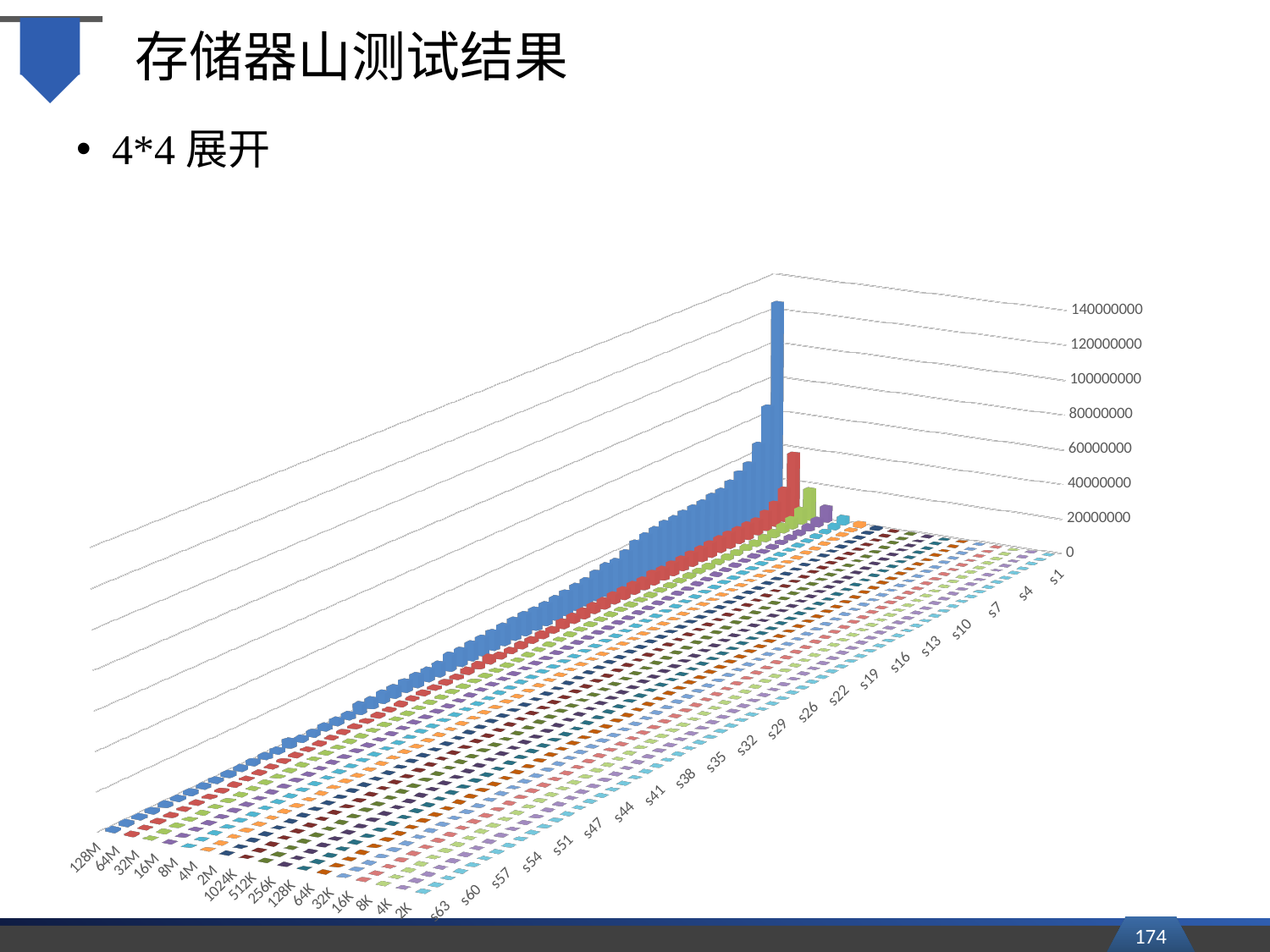
In the s1 series, which is larger: the value for 128M or the value for 2K? 128M What is the first size category labeled at the left end of the front axis? 128M What is the title of the slide containing the chart? 存储器山测试结果 Which stride series contains the tallest bar in the chart? s1 Is the value for 2K in the s4 series greater or less than 80000000? less Is the value for 128M in the s1 series greater or less than 20000000? greater How many size categories (from 128M to 2K) are labeled along the front axis of the chart? 17 Moving along the size axis from 128M toward 2K, do the values in the s1 series rise or fall? fall What kind of chart is shown on the slide? bar chart Is the tallest bar in the chart greater or less than 100000000? greater Which size category has the tallest bar in the chart? 128M What is the highest value shown on the vertical axis of the chart? 140000000